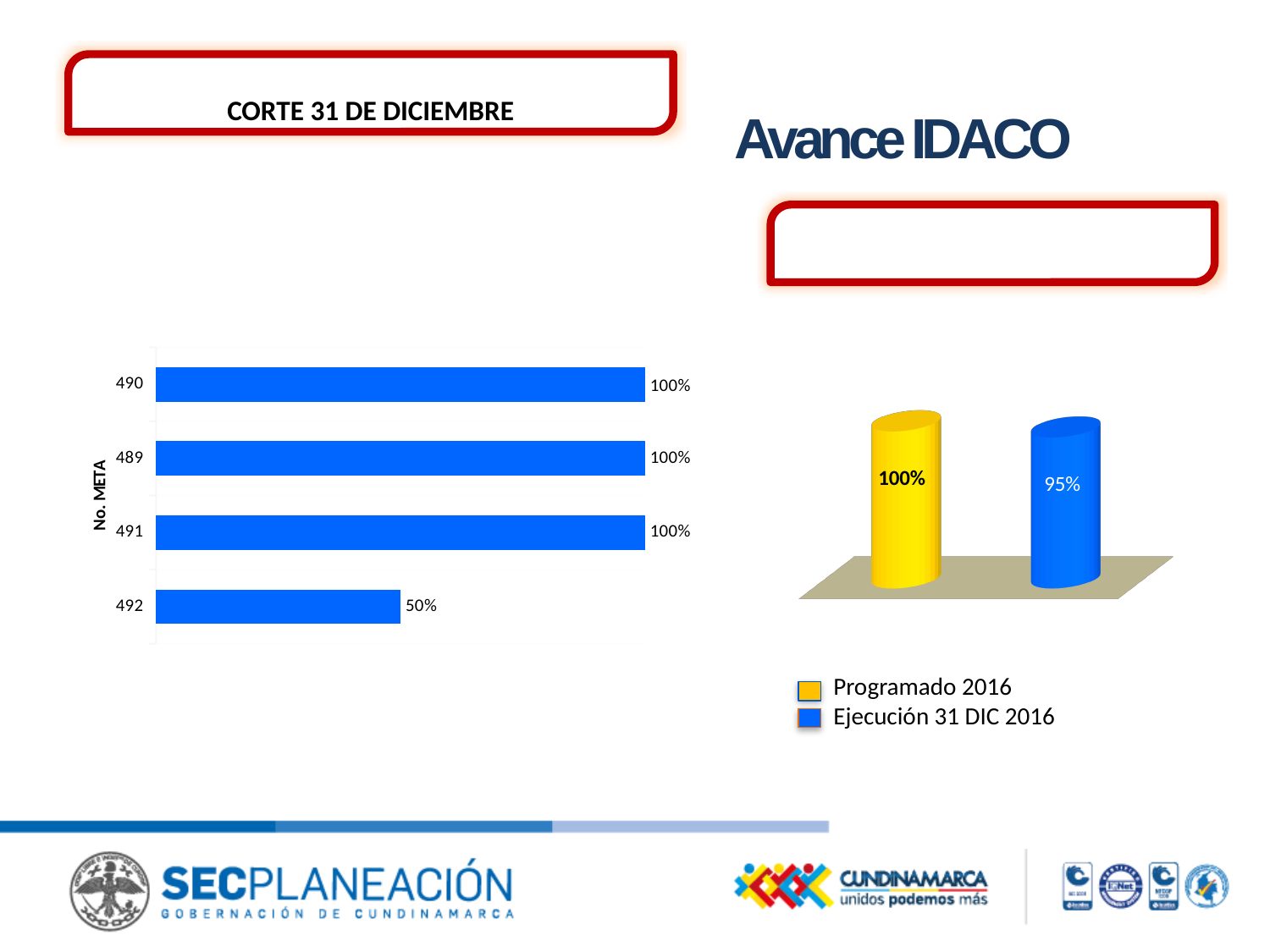
In the right chart (Avance IDACO), what is the value for Programado 2016? 100% What kind of chart is the left chart? bar chart In the right chart (Avance IDACO), how many series does the legend list? 2 In the left bar chart, what is the value for meta 490? 100% In the left bar chart, which meta has the lowest value? 492 In the right chart (Avance IDACO), what is the difference between Programado 2016 and Ejecución 31 DIC 2016? 5% In the left bar chart, what is the difference between the values for meta 491 and meta 492? 50% In the right chart (Avance IDACO), what is the value for Ejecución 31 DIC 2016? 95% In the left bar chart, which is larger, the value for meta 489 or meta 492? 489 In the left bar chart, what is the value for meta 492? 50% In the left bar chart, what is the label on the vertical axis? No. META In the left bar chart, how many metas are plotted? 4